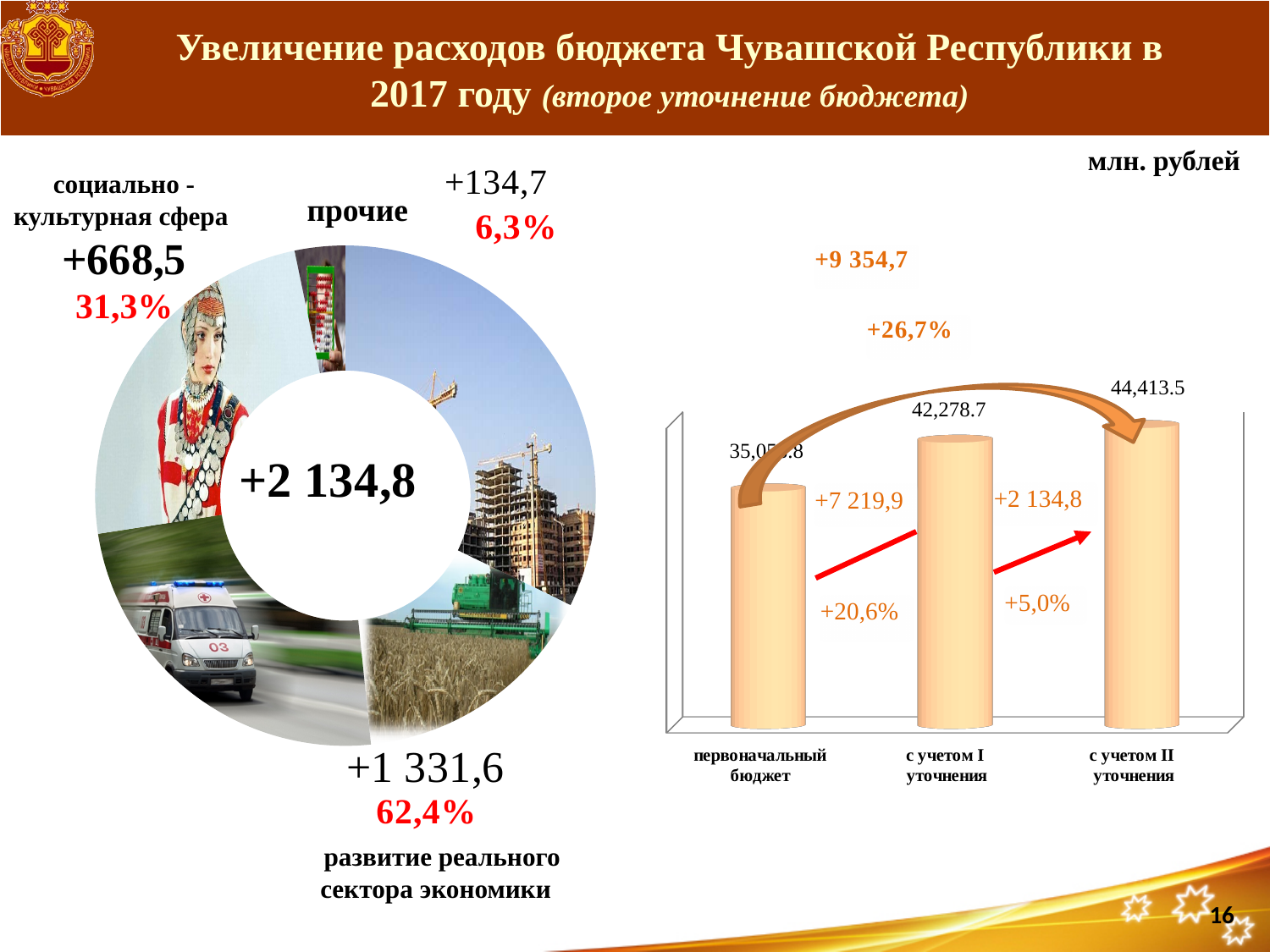
What kind of chart is shown on the right side of the slide? bar chart In the donut chart on the left, which segment is the largest? развитие реального сектора экономики In the donut chart on the left, what total value is shown in the centre? +2 134,8 In the bar chart on the right, do the values rise or fall from left to right? rise In the donut chart on the left, what share is shown for развитие реального сектора экономики? 62,4% In the donut chart on the left, what value is shown for социально-культурная сфера? +668,5 In the bar chart on the right, what is the value for с учетом II уточнения? 44,413.5 In the bar chart on the right, what is the value for с учетом I уточнения? 42,278.7 In the donut chart on the left, how many segments are there? 5 In the donut chart on the left, what share is shown for прочие? 6,3% In the donut chart on the left, which segment is the smallest? прочие In the bar chart on the right, what percentage increase is shown between первоначальный бюджет and с учетом I уточнения? +20,6%